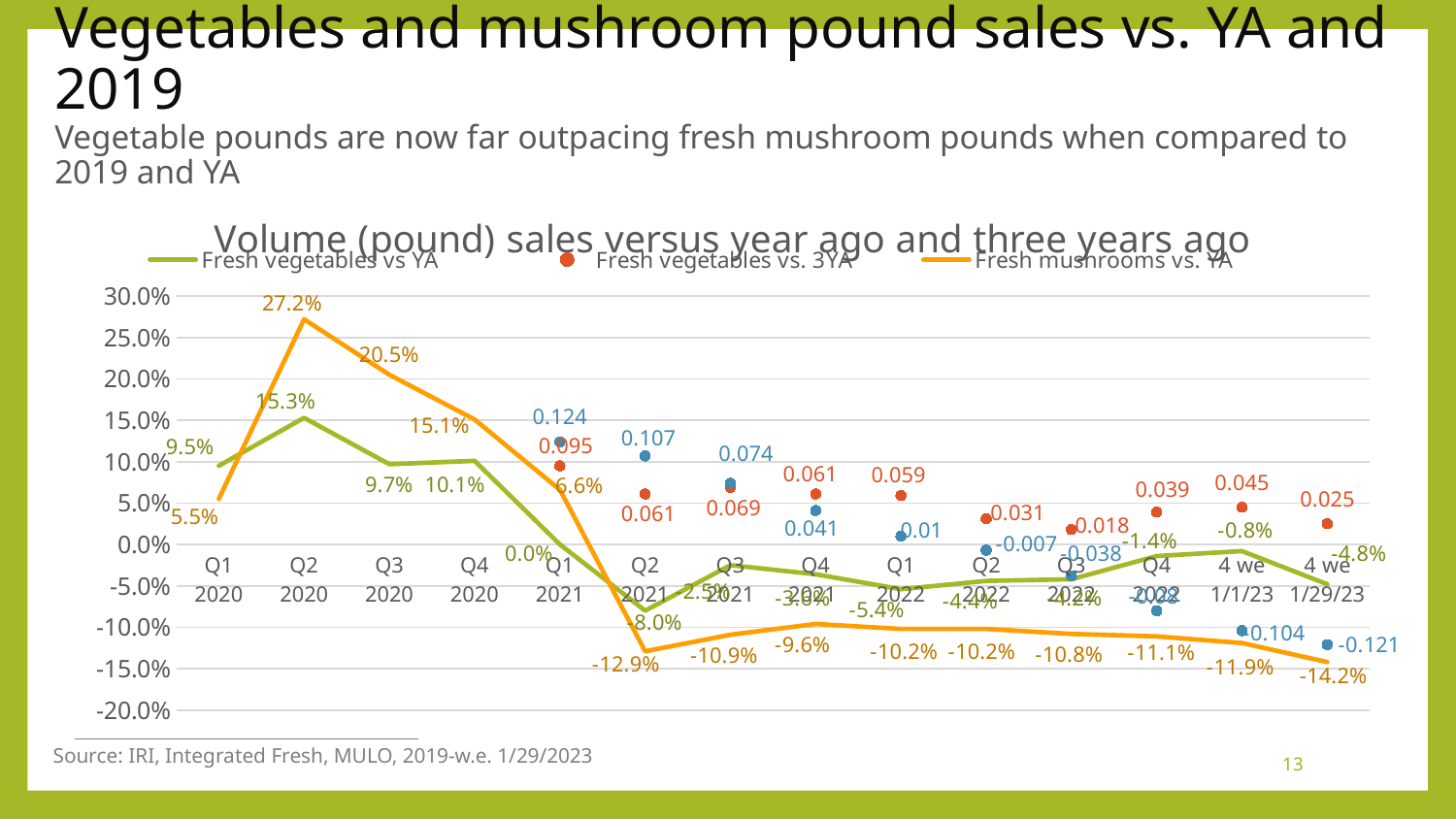
How many series does the legend list? 3 What kind of chart is shown on the slide? Line chart In which period is Fresh vegetables vs YA lowest? Q2 2021 What is the value for Fresh vegetables vs YA in Q2 2020? 15.3% In which period is Fresh mushrooms vs. YA highest? Q2 2020 What is the value for Fresh mushrooms vs. YA in Q2 2020? 27.2% In Q1 2020, which is larger: Fresh vegetables vs YA or Fresh mushrooms vs. YA? Fresh vegetables vs YA Does Fresh mushrooms vs. YA rise or fall from Q2 2020 to Q2 2021? Fall How many periods are shown on the x axis? 14 What is the value for Fresh vegetables vs. 3YA in Q1 2021? 0.095 In which period is Fresh mushrooms vs. YA lowest? 4 we 1/29/23 What is the difference between Fresh mushrooms vs. YA and Fresh vegetables vs YA in Q2 2020? 11.9 percentage points